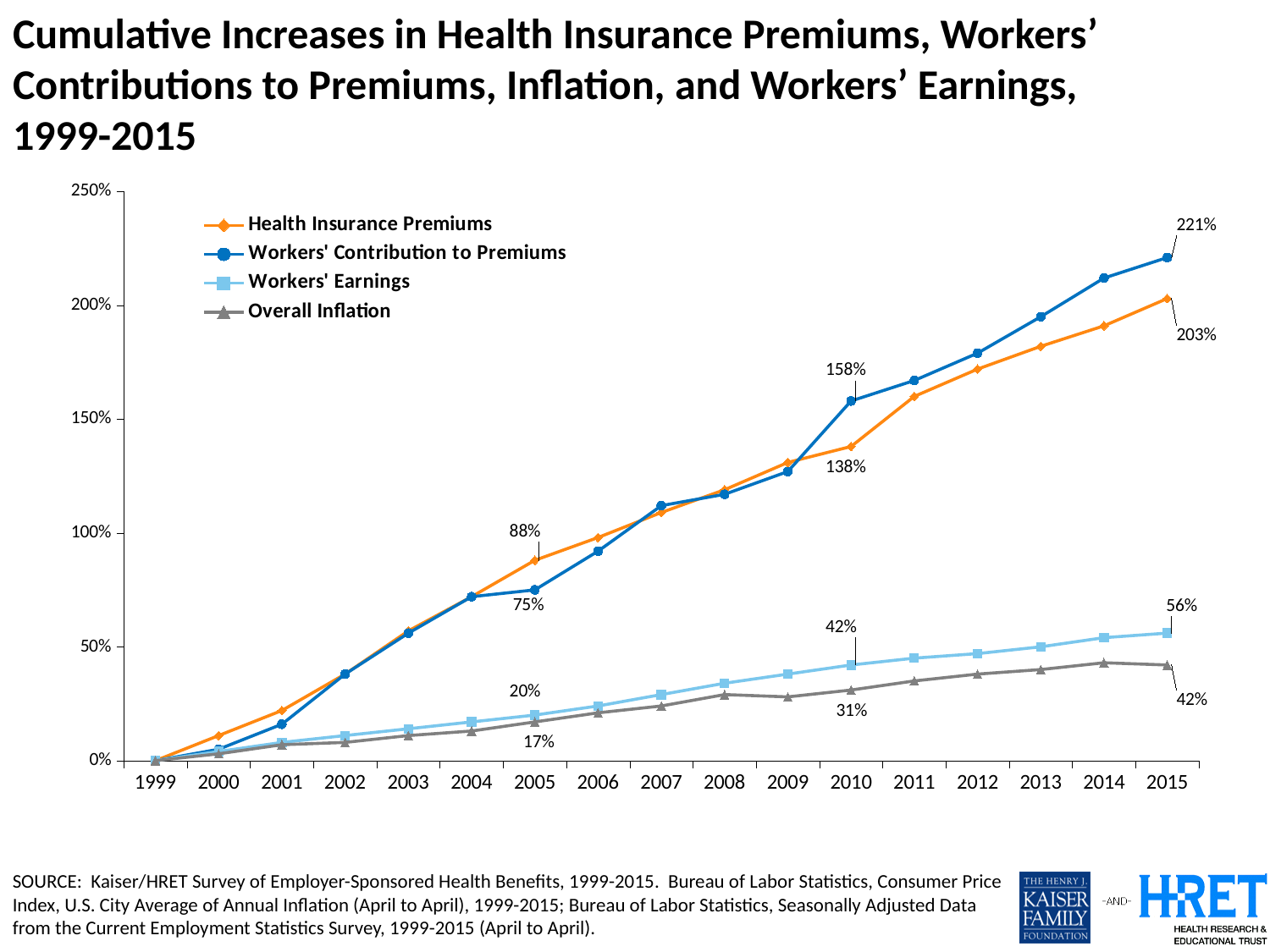
In 2015, how many percentage points higher is Workers' Contribution to Premiums than Health Insurance Premiums? 18 percentage points What kind of chart is shown on the slide? Line chart What is the value for Overall Inflation in 2005? 17% What is the cumulative increase in Health Insurance Premiums in 2015? 203% What is the cumulative increase in Workers' Contribution to Premiums in 2015? 221% What is the value for Workers' Earnings in 2010? 42% What is the value for Workers' Contribution to Premiums in 2005? 75% Which series has the highest value in 2015? Workers' Contribution to Premiums How many years are plotted along the x axis? 17 Is the value for Health Insurance Premiums in 2012 greater or less than 150%? greater In 2010, which is larger: Workers' Contribution to Premiums or Health Insurance Premiums? Workers' Contribution to Premiums How many series does the legend list? 4